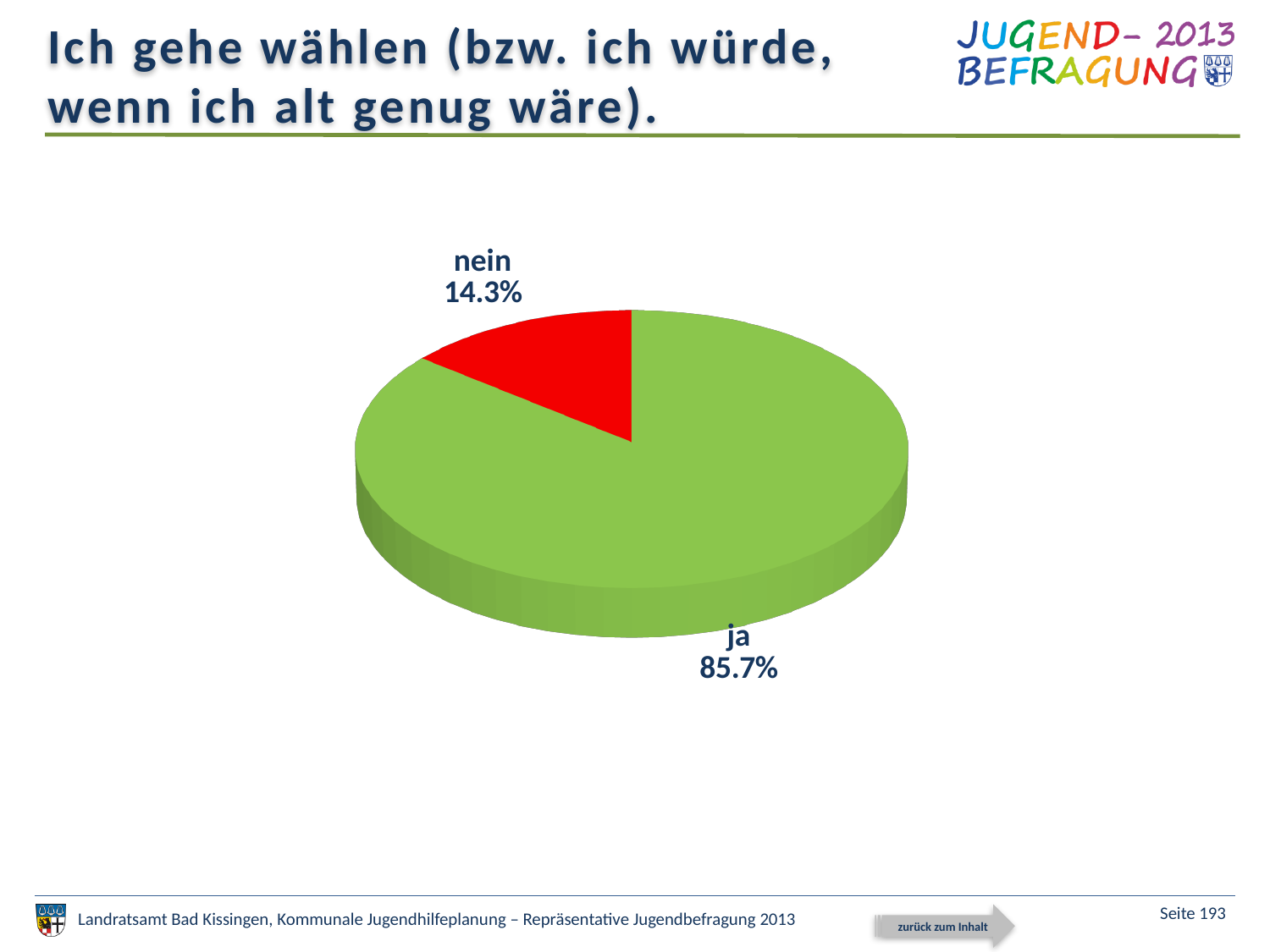
Which is larger, the share for "ja" or the share for "nein"? ja What colour is the "nein" slice? red Which answer has the smallest share of the pie? nein What percentage of respondents answered "ja"? 85.7% What colour is the "ja" slice? green How many slices does the pie chart have? 2 What is the difference in percentage points between "ja" and "nein"? 71.4 What is the total of the two slices shown? 100% Which answer has the largest share of the pie? ja What kind of chart is shown on the slide? pie chart What percentage of respondents answered "nein"? 14.3%